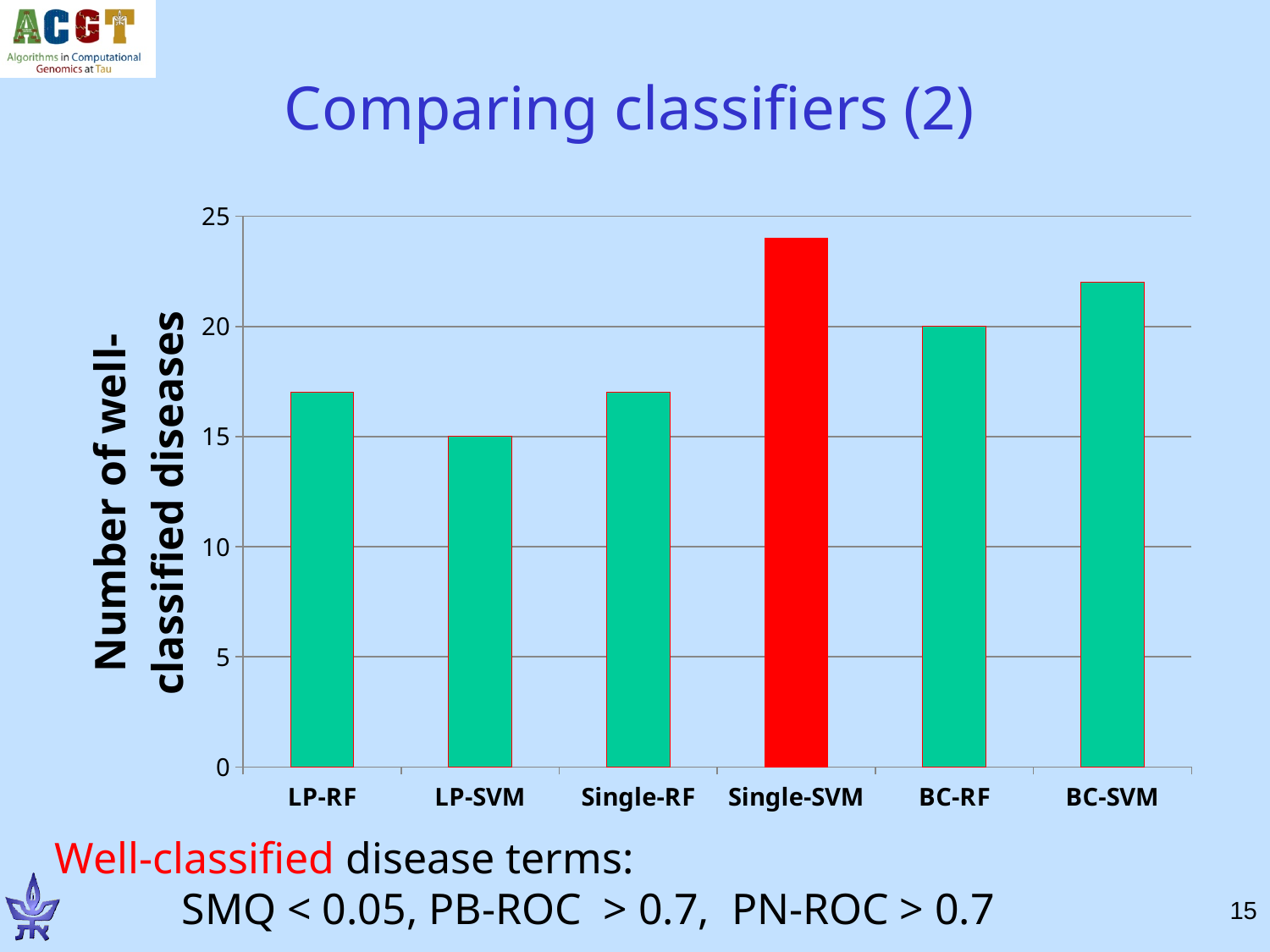
Is the value for LP-RF greater or less than 15? greater Is the value for Single-RF greater or less than 20? less What is the value for BC-RF? 20 How many classifiers are shown on the x axis? 6 Is the value for BC-SVM greater or less than 25? less What is the value for LP-SVM? 15 Which is larger, the value for BC-SVM or the value for BC-RF? BC-SVM Which bar is coloured red instead of green? Single-SVM Which classifier has the lowest number of well-classified diseases? LP-SVM Which classifier has the highest number of well-classified diseases? Single-SVM What kind of chart is shown on the slide? bar chart